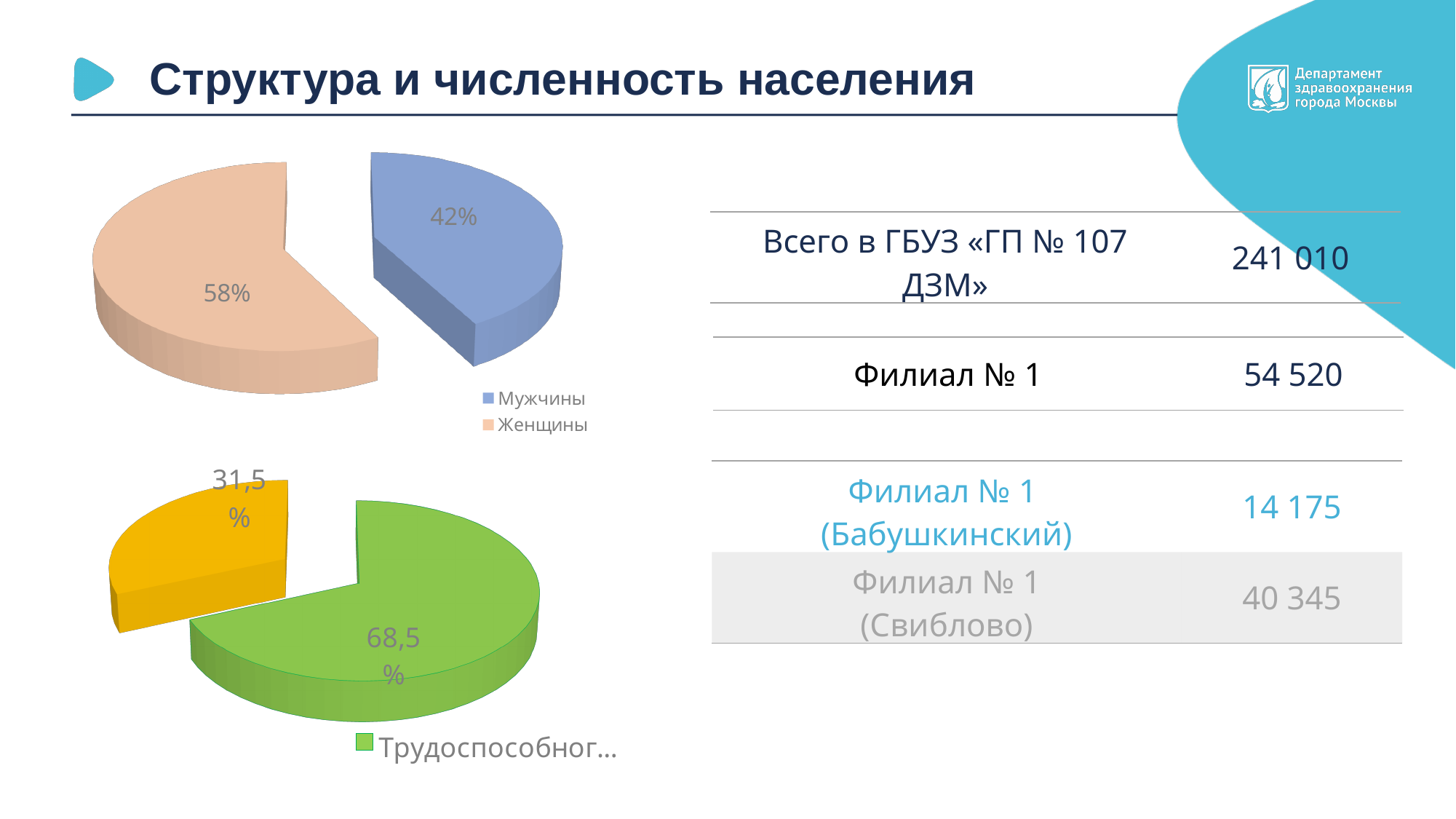
In the top pie chart, what share is labelled for Мужчины? 42% In the bottom pie chart, what percentage is labelled on the green slice? 68,5% In the bottom pie chart, what percentage is labelled on the yellow slice? 31,5% In the top pie chart, which category has the larger share, Мужчины or Женщины? Женщины In the bottom pie chart, which slice is the largest, the green one or the yellow one? Green How many entries does the legend of the top chart list? 2 In the top pie chart, what is the difference in percentage points between the Женщины and Мужчины slices? 16 In the top pie chart, what share is labelled for Женщины? 58% In the top pie chart, which colour represents Мужчины? Blue What type of chart is the top chart on the slide? Pie chart How many slices does the bottom pie chart have? 2 What type of chart is the bottom chart on the slide? Pie chart